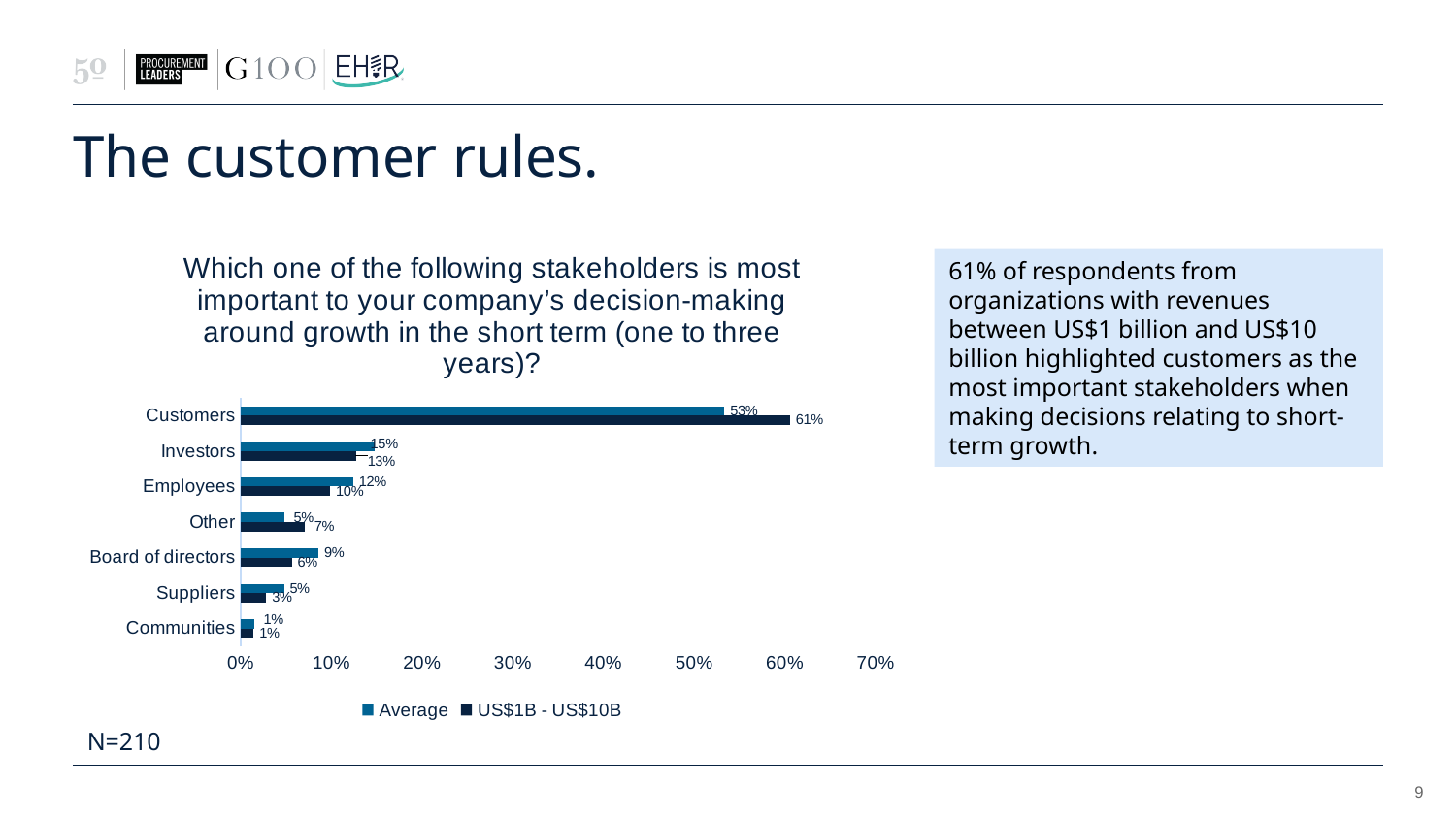
What is the US$1B - US$10B value for Customers? 61% How many stakeholder categories are shown on the chart? 7 What is the sample size stated below the chart? N=210 Which stakeholder has the highest Average value? Customers What is the difference between the US$1B - US$10B and Average values for Customers? 8% For Employees, which is larger: the Average value or the US$1B - US$10B value? Average What is the US$1B - US$10B value for Board of directors? 6% What is the Average value for Investors? 15% Which stakeholder has the lowest US$1B - US$10B value? Communities What is the Average value for Customers? 53% What kind of chart is shown on the slide? Bar chart How many series does the legend list? 2